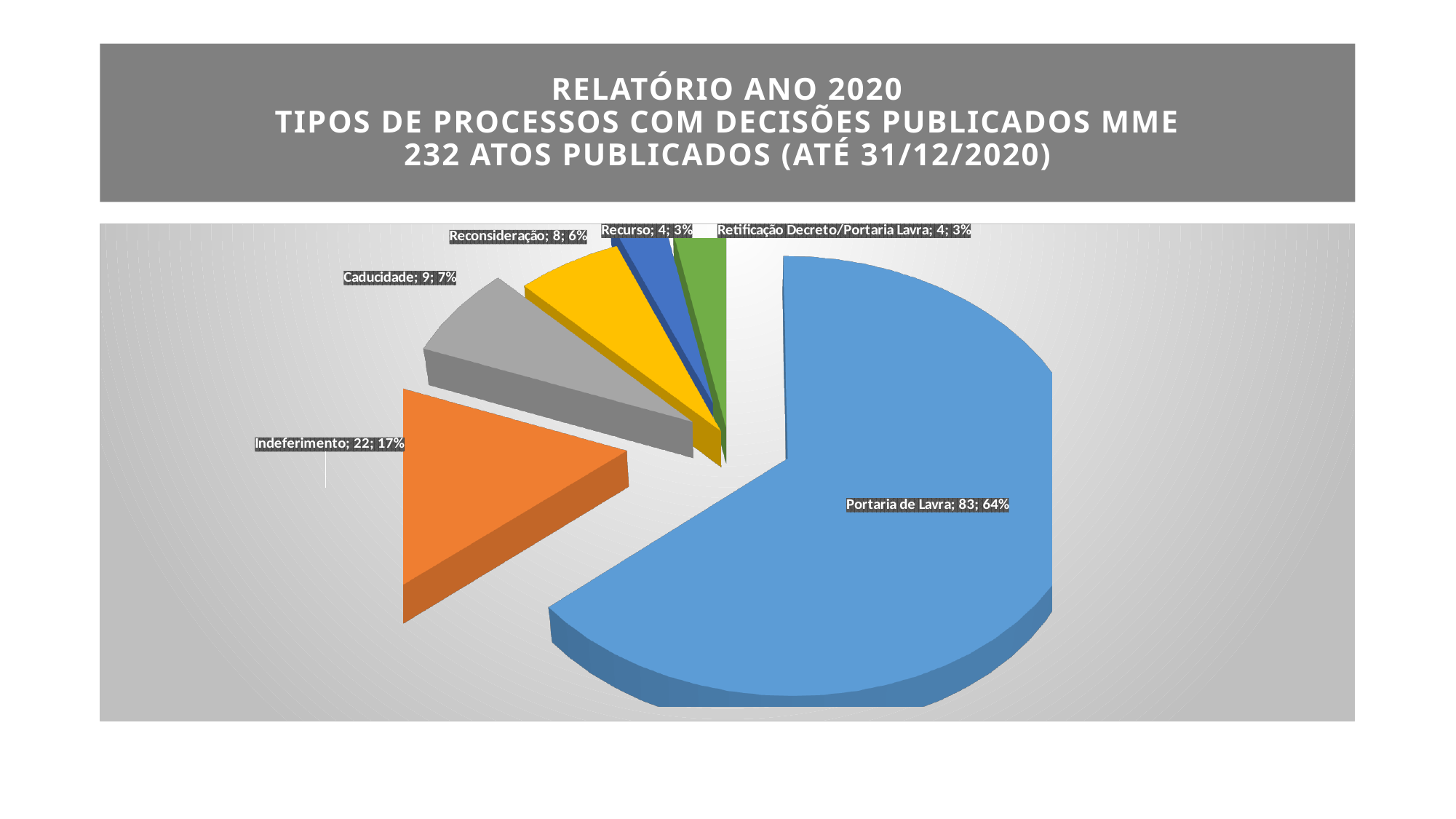
What percentage share does Indeferimento have? 17% What percentage share does Reconsideração have? 6% How many slices does the pie chart have? 6 What is the value shown for Portaria de Lavra? 83 What is the value shown for Caducidade? 9 What is the difference between the values for Portaria de Lavra and Indeferimento? 61 Which category has the largest slice of the pie? Portaria de Lavra What colour is the Indeferimento slice? orange What percentage share does Retificação Decreto/Portaria Lavra have? 3% What kind of chart is shown on the slide? pie chart Which is larger, the value for Caducidade or the value for Reconsideração? Caducidade What is the value shown for Recurso? 4